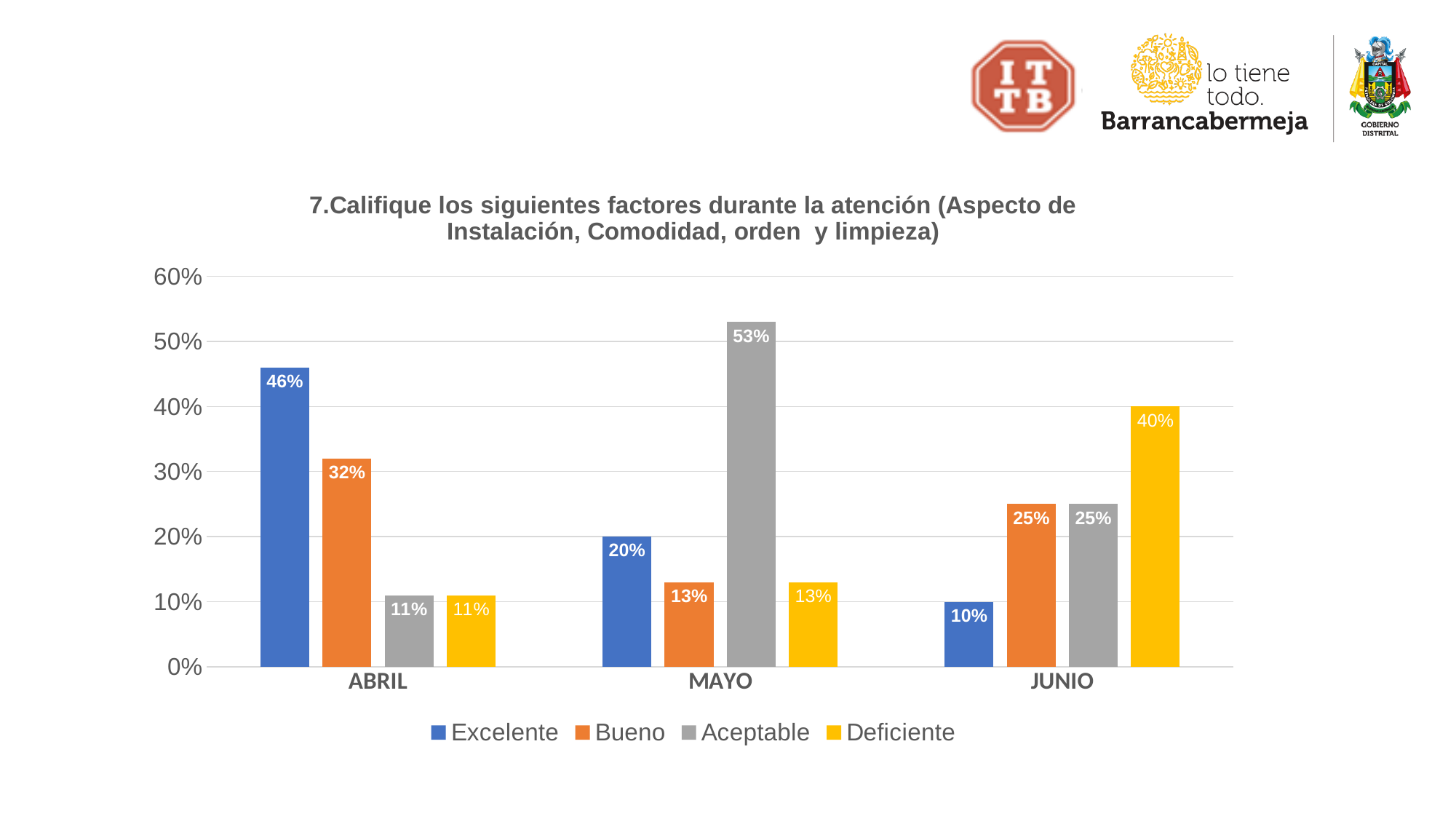
Which month has the highest value for Excelente? ABRIL How many series does the legend list? 4 What is the value for Aceptable in MAYO? 53% What is the value for Deficiente in JUNIO? 40% What is the value for Excelente in ABRIL? 46% Does the value for Excelente rise or fall from ABRIL to JUNIO? Fall What is the value for Bueno in MAYO? 13% How many months are shown on the x axis? 3 What is the difference between the Excelente values for ABRIL and JUNIO? 36% What kind of chart is shown? Bar chart Which is larger in JUNIO, Bueno or Excelente? Bueno Which month has the lowest value for Deficiente? ABRIL